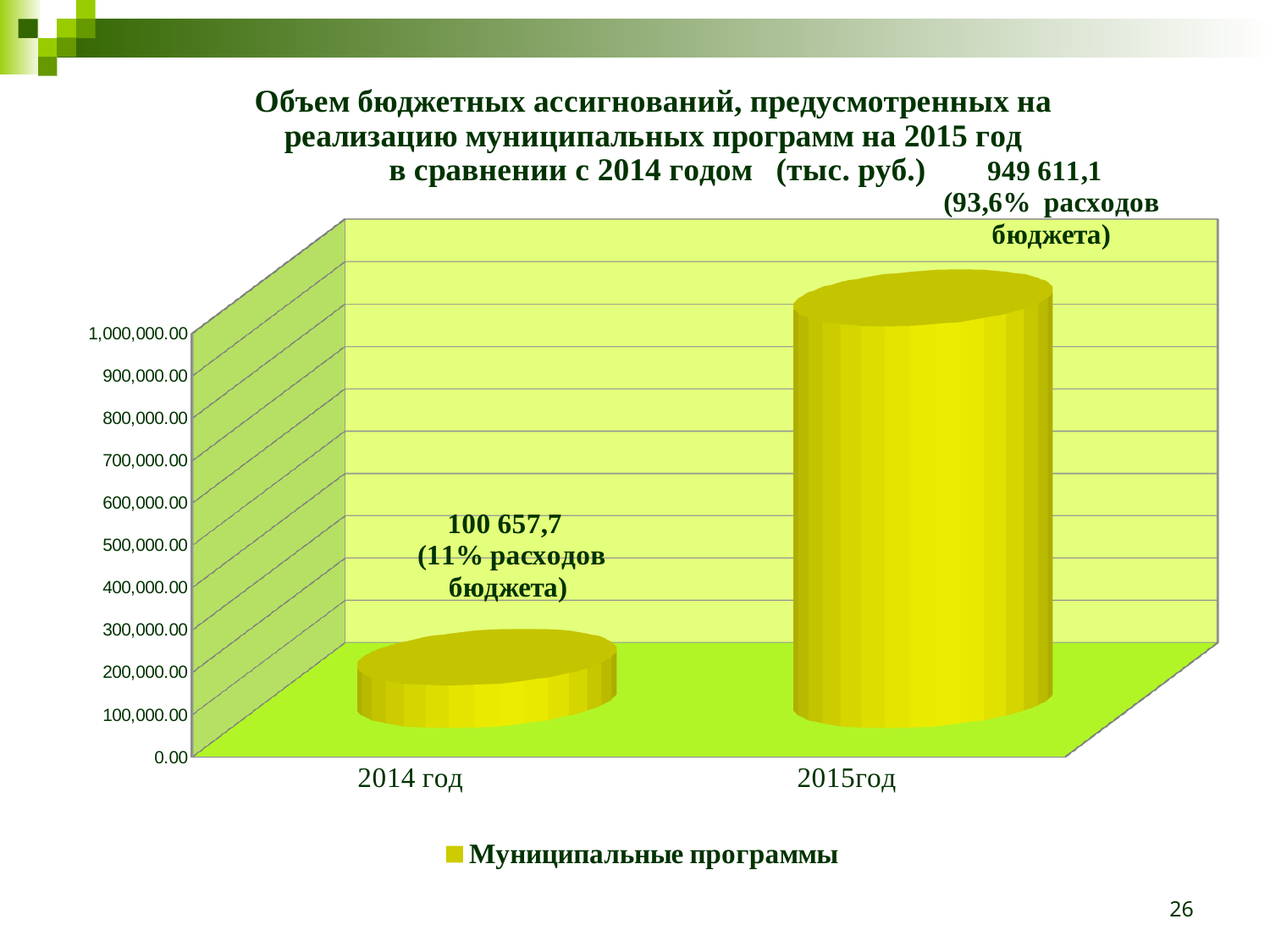
Which year has the higher value? 2015год Is the value for 2014 год greater or less than 200,000.00? less Which year has the lower value? 2014 год What is the difference between the values for 2015год and 2014 год? 848 953,4 What is the value for 2015год? 949 611,1 How many categories are shown on the x axis? 2 How many series does the legend list? 1 Do the values rise or fall from 2014 год to 2015год? Rise What is the value for 2014 год? 100 657,7 What kind of chart is shown on the slide? Bar chart Is the value for 2015год greater or less than 900,000.00? greater What series name is shown in the legend? Муниципальные программы